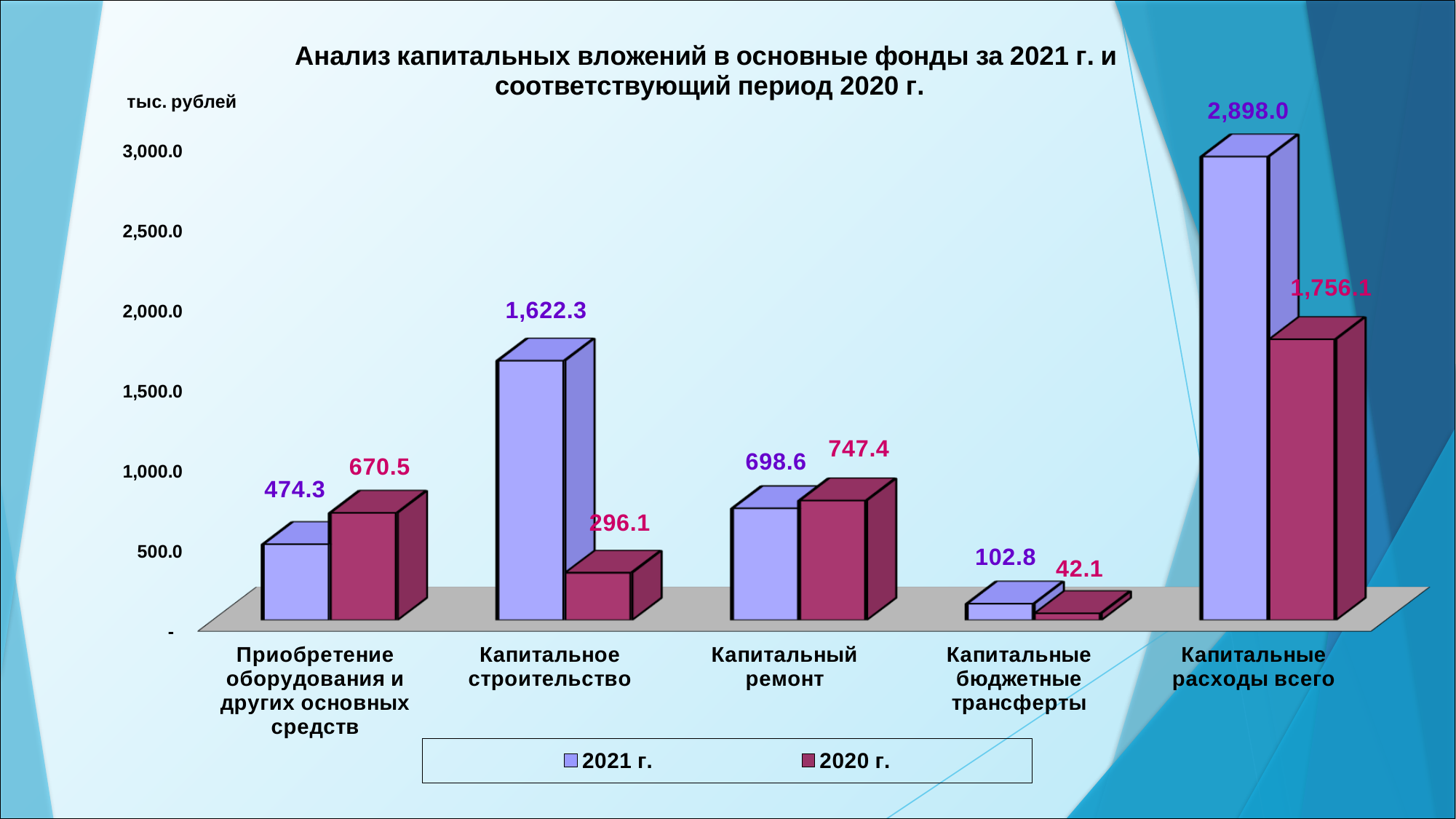
What is the value for 2020 г. in the category Капитальный ремонт? 747.4 Which category has the highest value for 2021 г.? Капитальные расходы всего What is the value for 2020 г. in the category Капитальные бюджетные трансферты? 42.1 What type of chart is shown on the slide? Bar chart Which category has the lowest value for 2020 г.? Капитальные бюджетные трансферты Is the 2021 г. value for Капитальное строительство greater or less than 1,500.0? greater What is the difference between the 2020 г. and 2021 г. values for Приобретение оборудования и других основных средств? 196.2 What is the value for 2021 г. in the category Капитальное строительство? 1,622.3 What is the difference between the 2021 г. and 2020 г. values for Капитальные расходы всего? 1,141.9 Which is larger for Капитальный ремонт: the 2021 г. value or the 2020 г. value? 2020 г. How many categories are shown on the x axis? 5 How many series does the legend list? 2